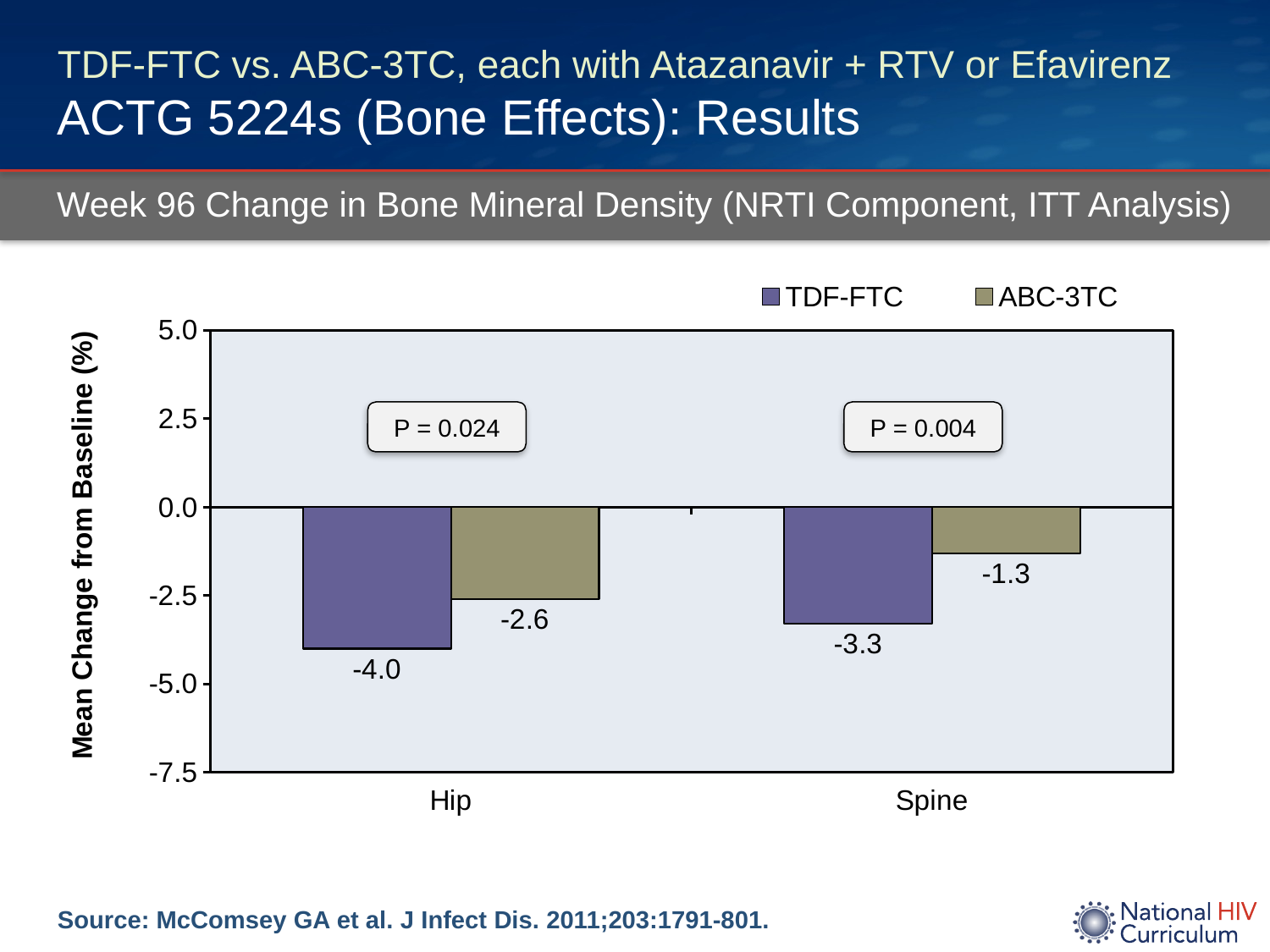
What is the difference between the TDF-FTC and ABC-3TC values at the Hip? 1.4 What kind of chart is shown on the slide? Bar chart What is the mean change from baseline for TDF-FTC at the Hip? -4.0 What is the mean change from baseline for TDF-FTC at the Spine? -3.3 Which bar shows the largest decrease in bone mineral density? TDF-FTC at the Hip What is the difference between the TDF-FTC and ABC-3TC values at the Spine? 2.0 Which series shows a larger decrease at the Spine, TDF-FTC or ABC-3TC? TDF-FTC What is the mean change from baseline for ABC-3TC at the Spine? -1.3 What is the mean change from baseline for ABC-3TC at the Hip? -2.6 Which bar shows the smallest decrease in bone mineral density? ABC-3TC at the Spine What P value is shown for the Spine comparison? P = 0.004 How many series does the legend list? 2